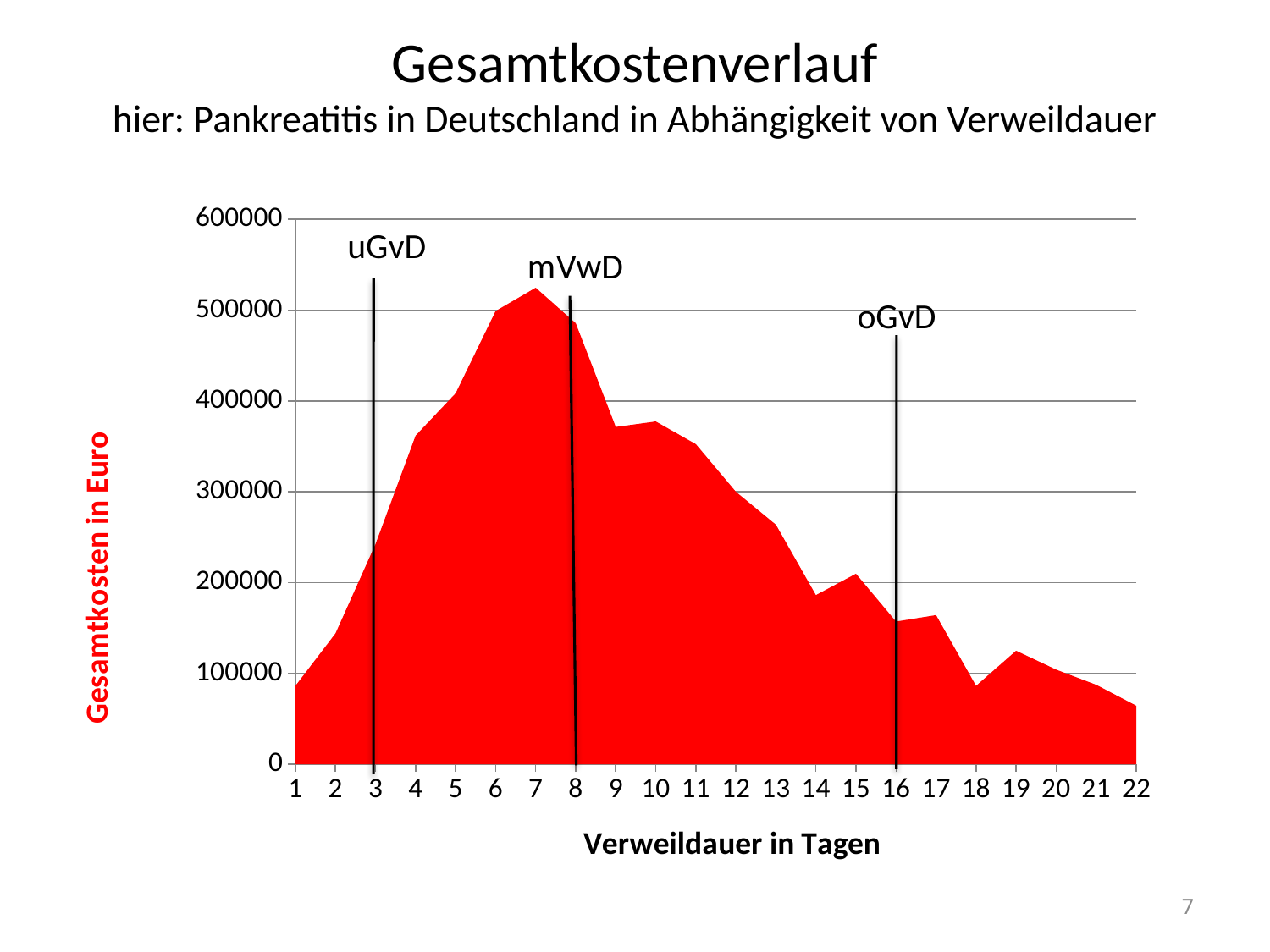
Which has higher Gesamtkosten, day 5 or day 15? day 5 Is the value for day 3 greater or less than 200000? greater Is the value for day 4 greater or less than 300000? greater At which Verweildauer (day) are the Gesamtkosten lowest? 22 What kind of chart is shown on the slide? area chart Do the Gesamtkosten rise or fall from day 7 to day 22? fall Which label marks the vertical line at day 16? oGvD How many days (x-axis categories) are plotted on the chart? 22 Is the value for day 13 greater or less than 300000? less What is the title of the y axis? Gesamtkosten in Euro At which Verweildauer (day) are the Gesamtkosten highest? 7